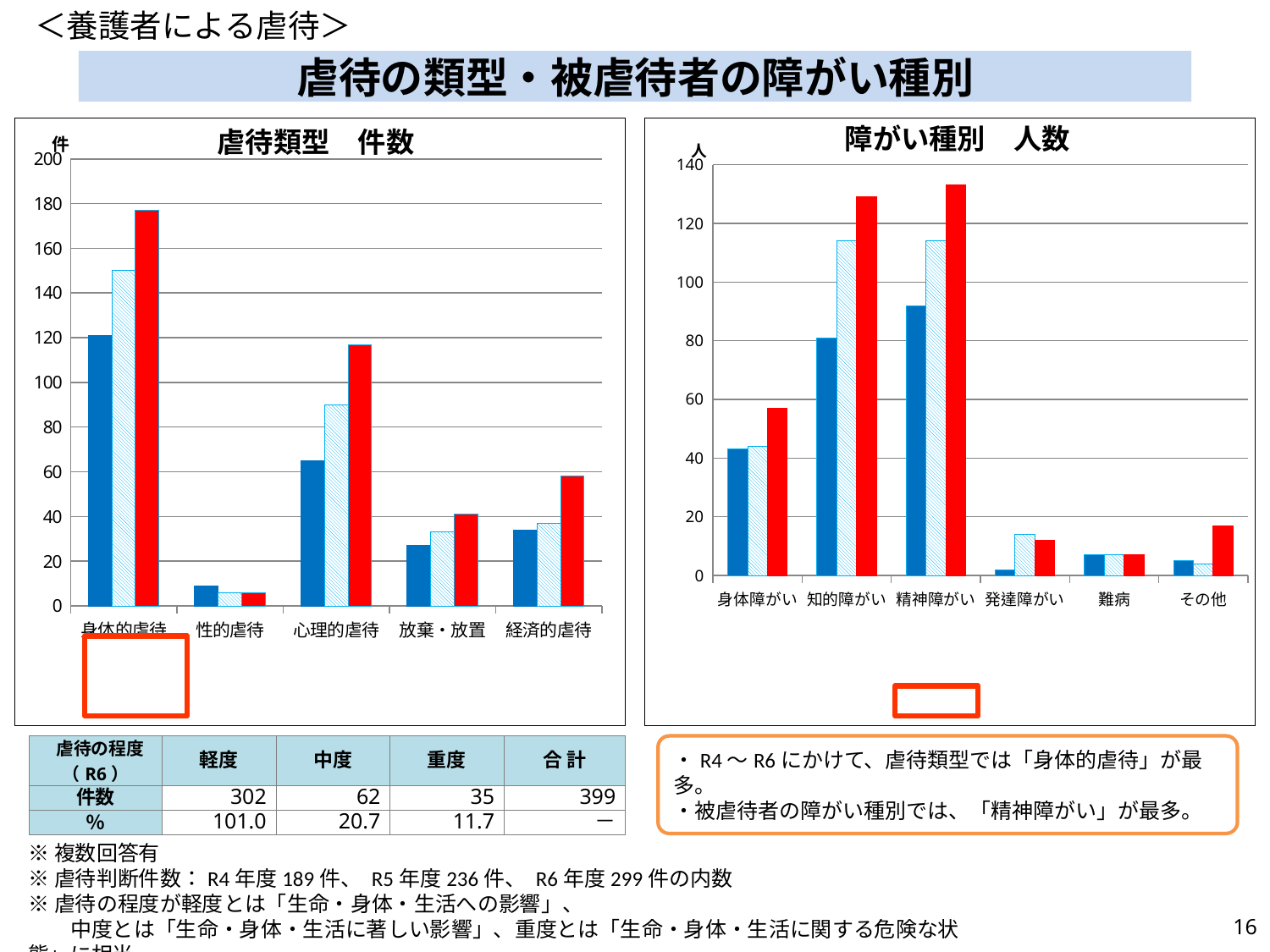
How many categories are shown on the x axis of the left chart (虐待類型 件数)? 5 In the right chart (障がい種別 人数), are all the bars for 難病 greater or less than 20? less What kind of chart is the left chart titled 虐待類型 件数? bar chart In the right chart (障がい種別 人数), which category has the tallest bar? 精神障がい What is the maximum value shown on the y axis of the right chart (障がい種別 人数)? 140 In the left chart (虐待類型 件数), which category has taller bars: 心理的虐待 or 放棄・放置? 心理的虐待 In the left chart (虐待類型 件数), are all the bars for 性的虐待 greater or less than 20? less In the right chart (障がい種別 人数), which category has taller bars: 知的障がい or 身体障がい? 知的障がい How many categories are shown on the x axis of the right chart (障がい種別 人数)? 6 In the left chart (虐待類型 件数), which category has the tallest bar? 身体的虐待 In the right chart (障がい種別 人数), is the tallest bar for 精神障がい greater or less than 120? greater In the left chart (虐待類型 件数), which category has the shortest bars overall? 性的虐待